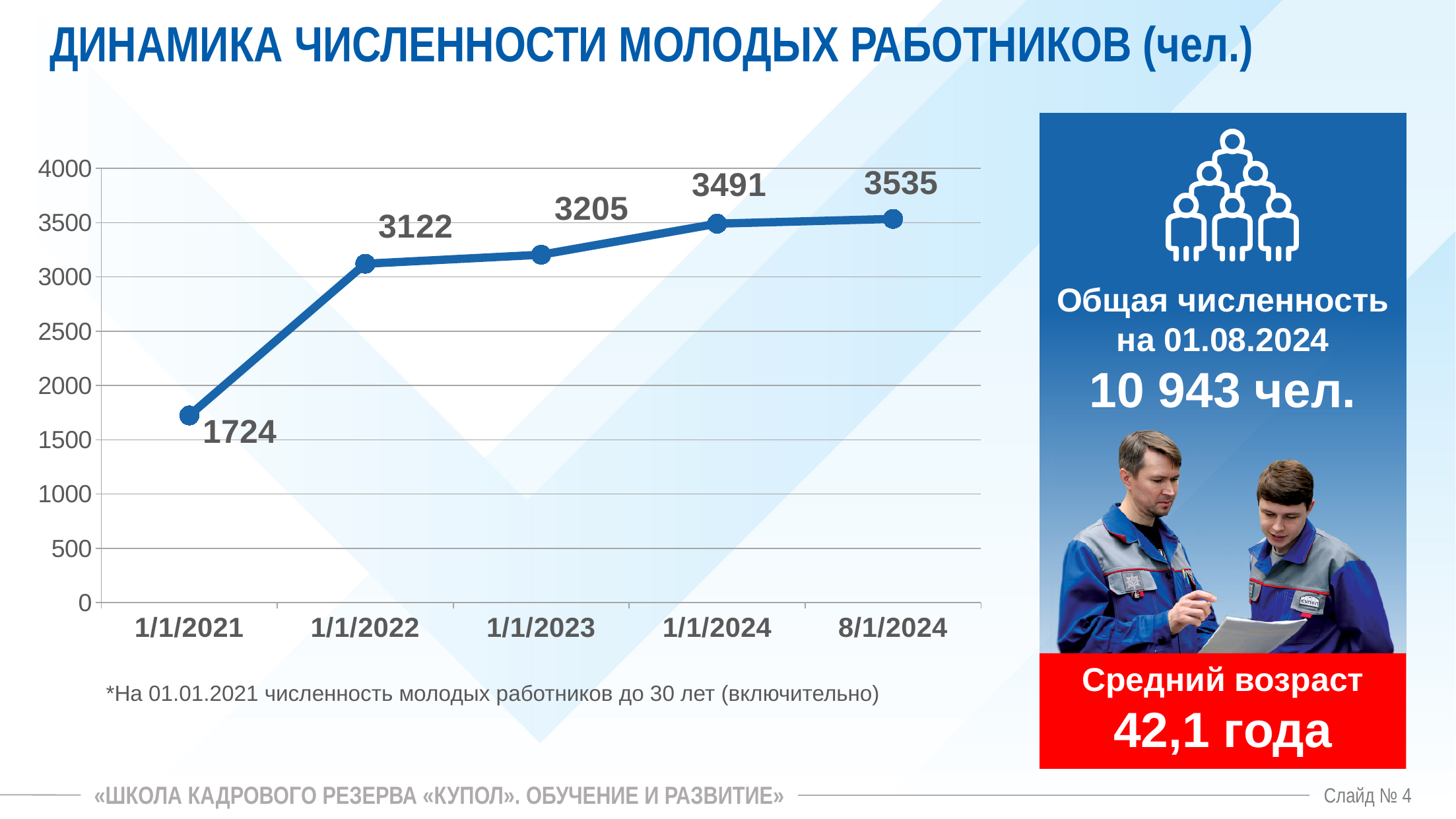
What is the difference between the values for 1/1/2022 and 1/1/2021? 1398 What kind of chart is shown on the slide? line chart Is the value for 1/1/2024 greater or less than 3000? greater Which date has the lowest value? 1/1/2021 What is the value for 1/1/2021? 1724 What is the value for 8/1/2024? 3535 What is the difference between the values for 1/1/2024 and 1/1/2023? 286 How many data points are plotted on the chart? 5 Which date has the highest value? 8/1/2024 What is the value for 1/1/2023? 3205 Do the values rise or fall from 1/1/2021 to 8/1/2024? rise Which is larger, the value for 1/1/2022 or the value for 1/1/2023? 1/1/2023